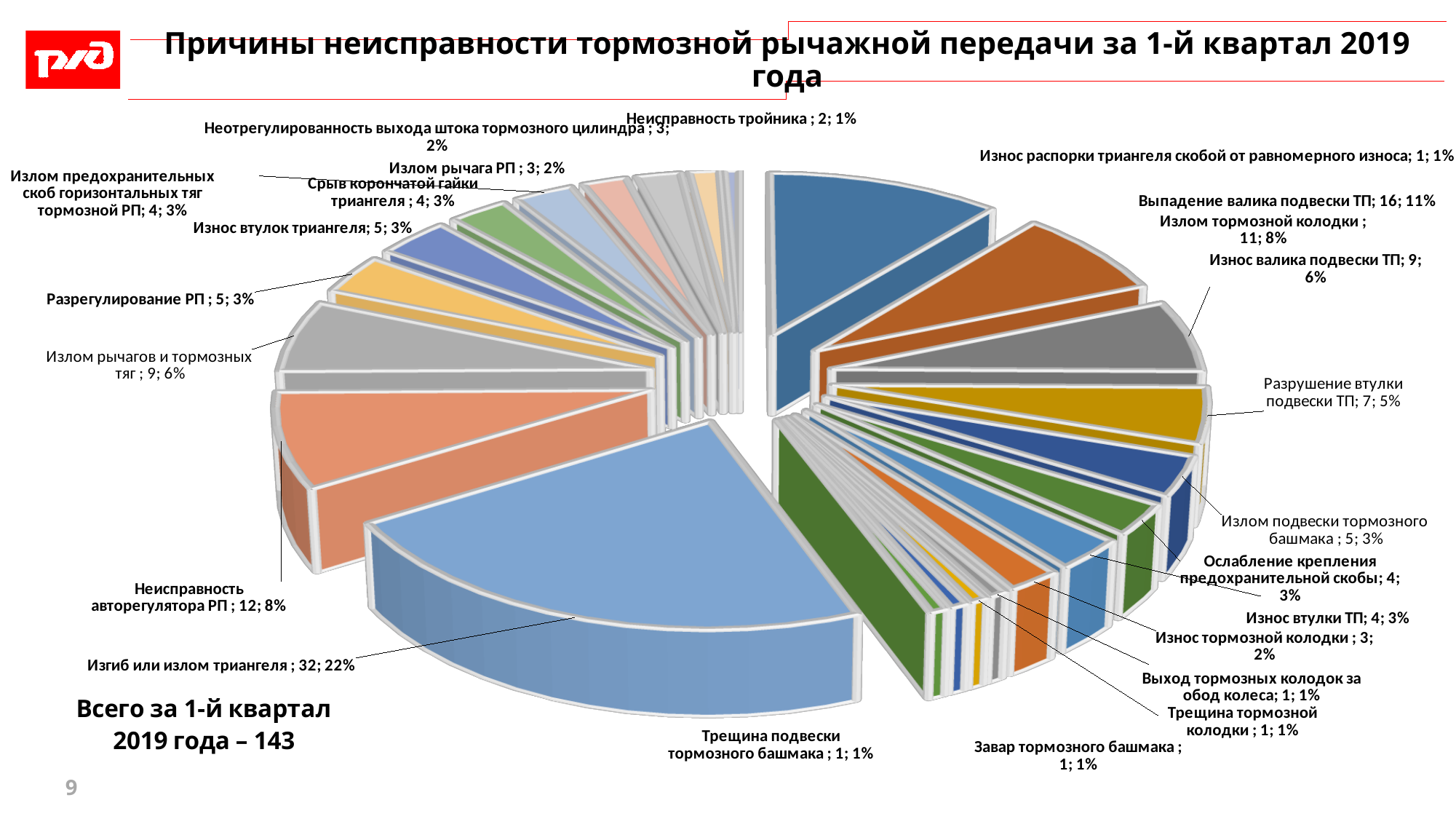
What share of the pie does «Разрушение втулки подвески ТП» represent? 5% Which is larger: «Излом тормозной колодки» or «Износ валика подвески ТП»? Излом тормозной колодки What is the value for «Выпадение валика подвески ТП»? 16; 11% What is the difference between the counts for «Изгиб или излом триангеля» and «Выпадение валика подвески ТП»? 16 What is the difference between the counts for «Неисправность авторегулятора РП» and «Излом рычагов и тормозных тяг»? 3 What is the title of the chart on the slide? Причины неисправности тормозной рычажной передачи за 1-й квартал 2019 года Which category has the largest slice of the pie? Изгиб или излом триангеля What kind of chart is shown on the slide? Pie chart How many categories are shown in the pie chart? 23 What is the value for «Неисправность авторегулятора РП»? 12; 8% What is the value for «Изгиб или излом триангеля»? 32; 22% What is the total number of cases for the 1st quarter of 2019 stated on the slide? 143